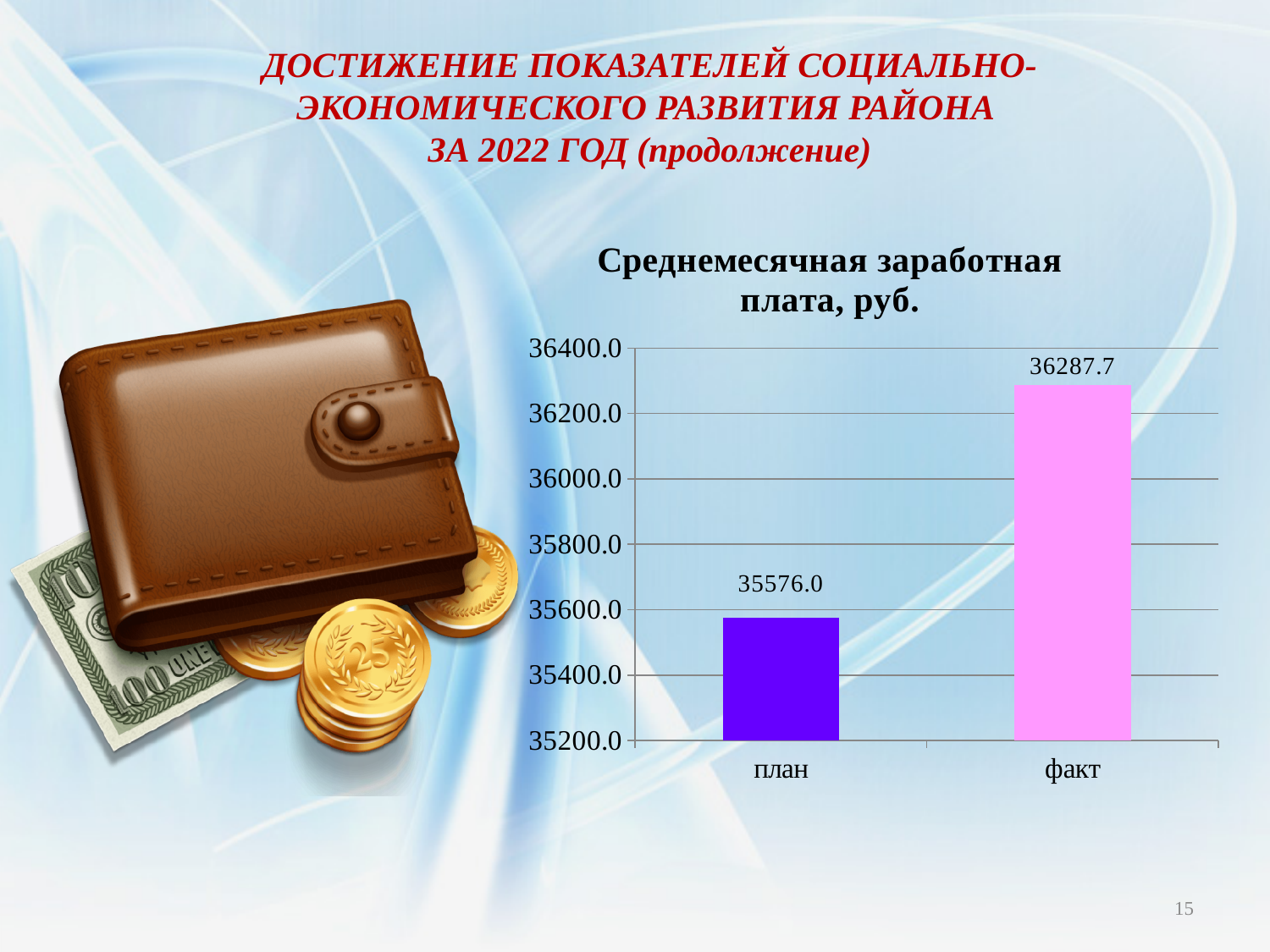
How many categories are shown on the chart? 2 Which is larger, the value for план or the value for факт? факт What is the difference between the values for факт and план? 711.7 Which category has the highest value? факт Which category has the lowest value? план Is the value for факт greater or less than 36000.0? greater What is the value for факт? 36287.7 What kind of chart is shown on the slide? bar chart What is the value for план? 35576.0 Is the value for план greater or less than 35800.0? less What colour is the bar for факт? pink What is the title of the chart? Среднемесячная заработная плата, руб.